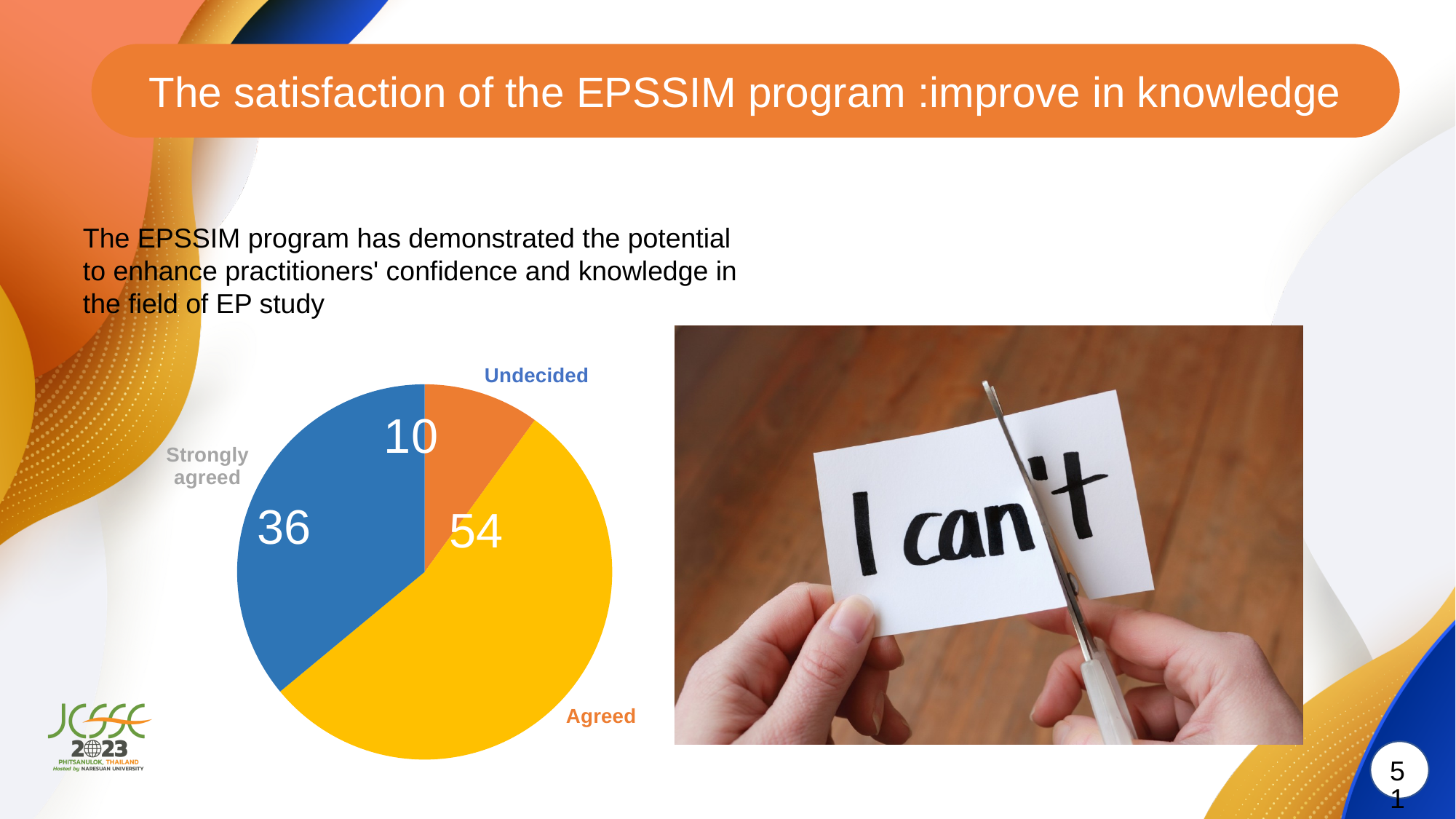
What colour is the Strongly agreed slice? Blue Which is larger, the Strongly agreed value or the Undecided value? Strongly agreed What kind of chart is shown on the slide? Pie chart What is the value for the Undecided slice? 10 How many slices does the pie chart have? 3 What is the value for the Agreed slice? 54 What is the value for the Strongly agreed slice? 36 What is the difference between the Strongly agreed and Undecided values? 26 What is the difference between the Agreed and Strongly agreed values? 18 What share of the pie does the Agreed slice represent? 54% Which category has the largest slice of the pie? Agreed Which category has the smallest slice of the pie? Undecided